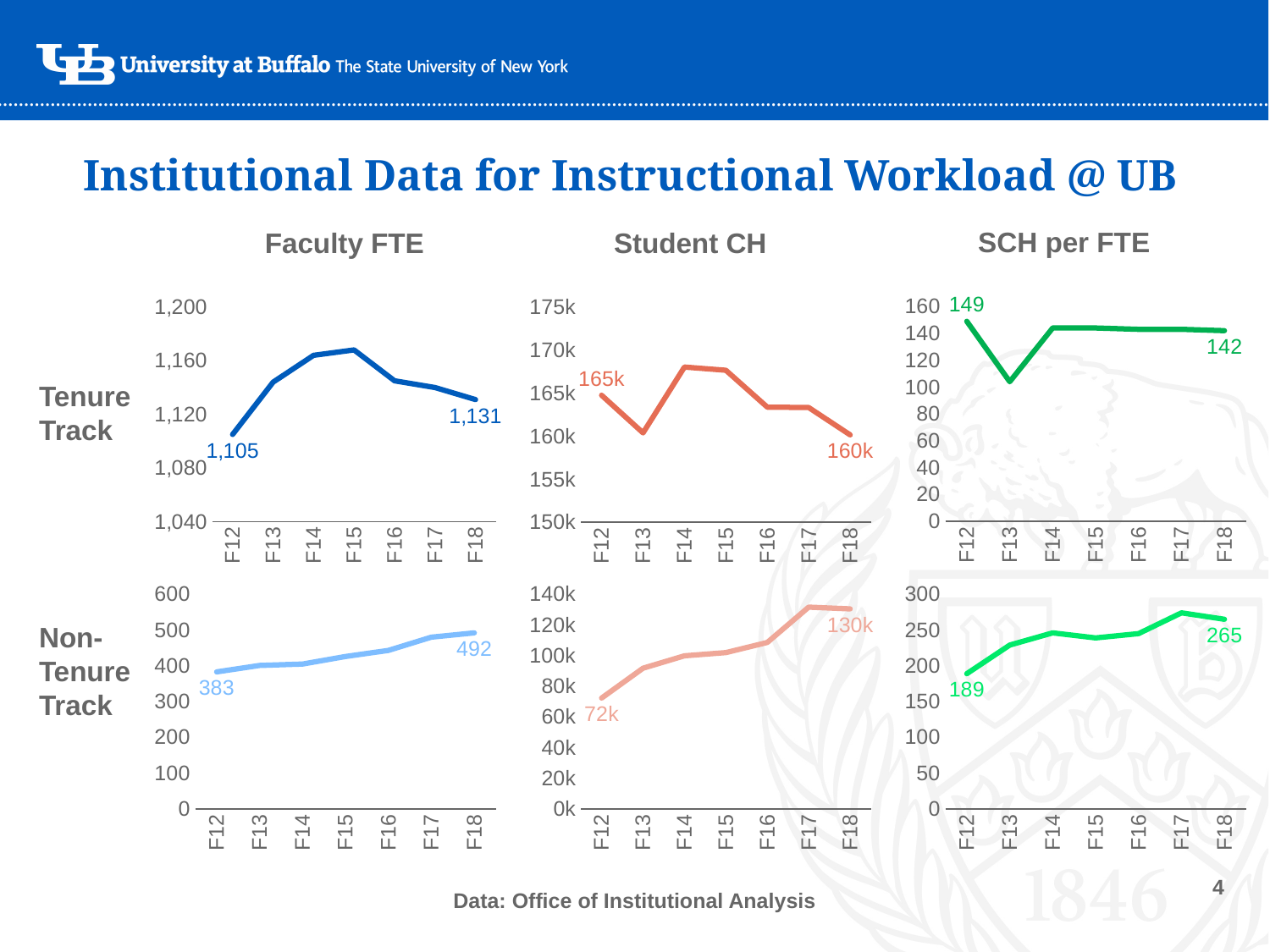
In the Tenure Track SCH per FTE chart, what is the value for F18? 142 In the Non-Tenure Track Student CH chart, what is the value for F12? 72k In the Non-Tenure Track Student CH chart, is the value for F17 greater or less than 120k? greater How many data points are plotted in the Non-Tenure Track Faculty FTE chart? 7 In the Tenure Track Faculty FTE chart, what is the value for F18? 1,131 In the Tenure Track Faculty FTE chart, what is the value for F12? 1,105 In the Non-Tenure Track Faculty FTE chart, what is the value for F18? 492 In the Non-Tenure Track Faculty FTE chart, what is the difference between the F18 value and the F12 value? 109 In the Tenure Track SCH per FTE chart, which year has the lowest value? F13 In the Tenure Track SCH per FTE chart, is the value for F13 greater or less than 120? less In the Tenure Track Faculty FTE chart, which year has the highest value? F15 In the Non-Tenure Track SCH per FTE chart, what is the difference between the F18 value and the F12 value? 76